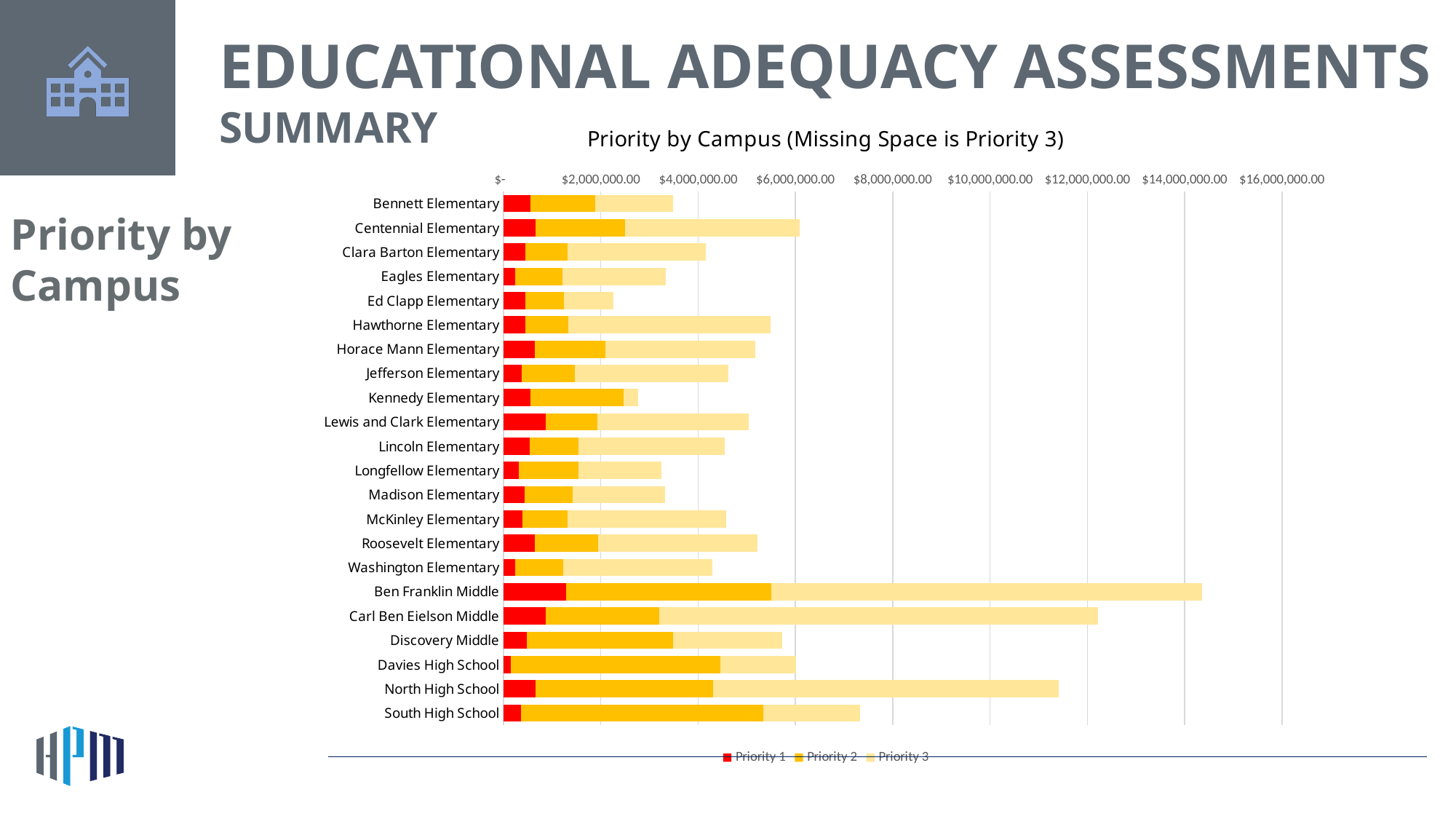
Which has the larger total bar, Centennial Elementary or Bennett Elementary? Centennial Elementary What type of chart is shown on the slide? Bar chart How many series does the legend list? 3 Is the total value for Ed Clapp Elementary greater or less than $4,000,000.00? less How many campuses are plotted on the chart? 22 Which campus has the lowest total bar? Ed Clapp Elementary Which campus has the highest total bar? Ben Franklin Middle Is the total value for North High School greater or less than $10,000,000.00? greater Is the total value for Ben Franklin Middle greater or less than $12,000,000.00? greater Which has the larger total bar, South High School or Davies High School? South High School What is the title of the chart? Priority by Campus (Missing Space is Priority 3) Which colour represents Priority 1 in the legend? Red